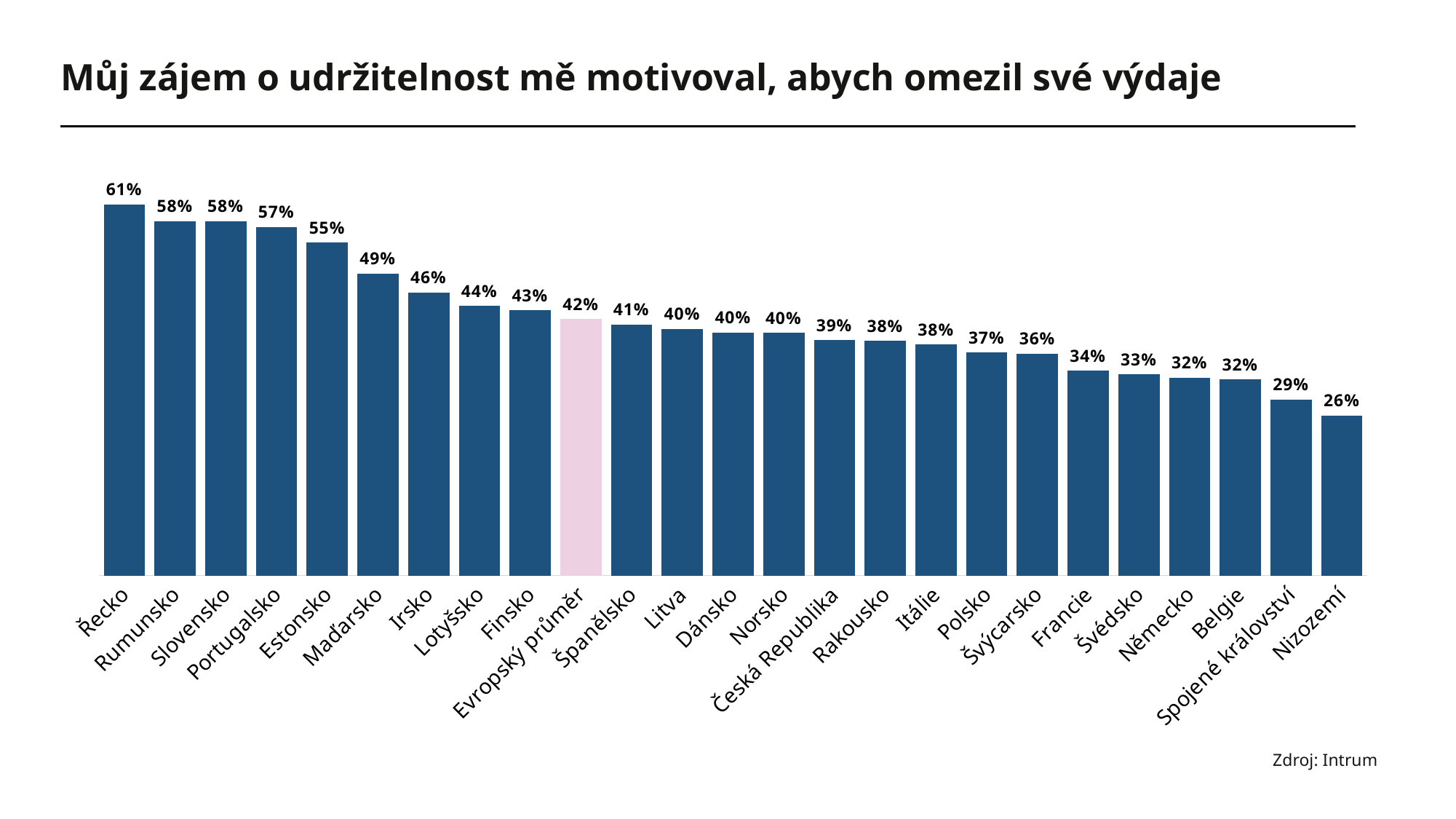
What is the value for Řecko? 61% Which is larger, the value for Polsko or the value for Estonsko? Estonsko What is the value for Evropský průměr? 42% Which bar is highlighted in a different colour (pink) from the others? Evropský průměr What is the difference between the values for Řecko and Nizozemí? 35% How many categories are shown on the x axis? 25 What kind of chart is shown on the slide? Bar chart Which category has the lowest value? Nizozemí Which category has the highest value? Řecko What is the value for Česká Republika? 39% What is the difference between the values for Maďarsko and Evropský průměr? 7% Which is larger, the value for Finsko or the value for Francie? Finsko